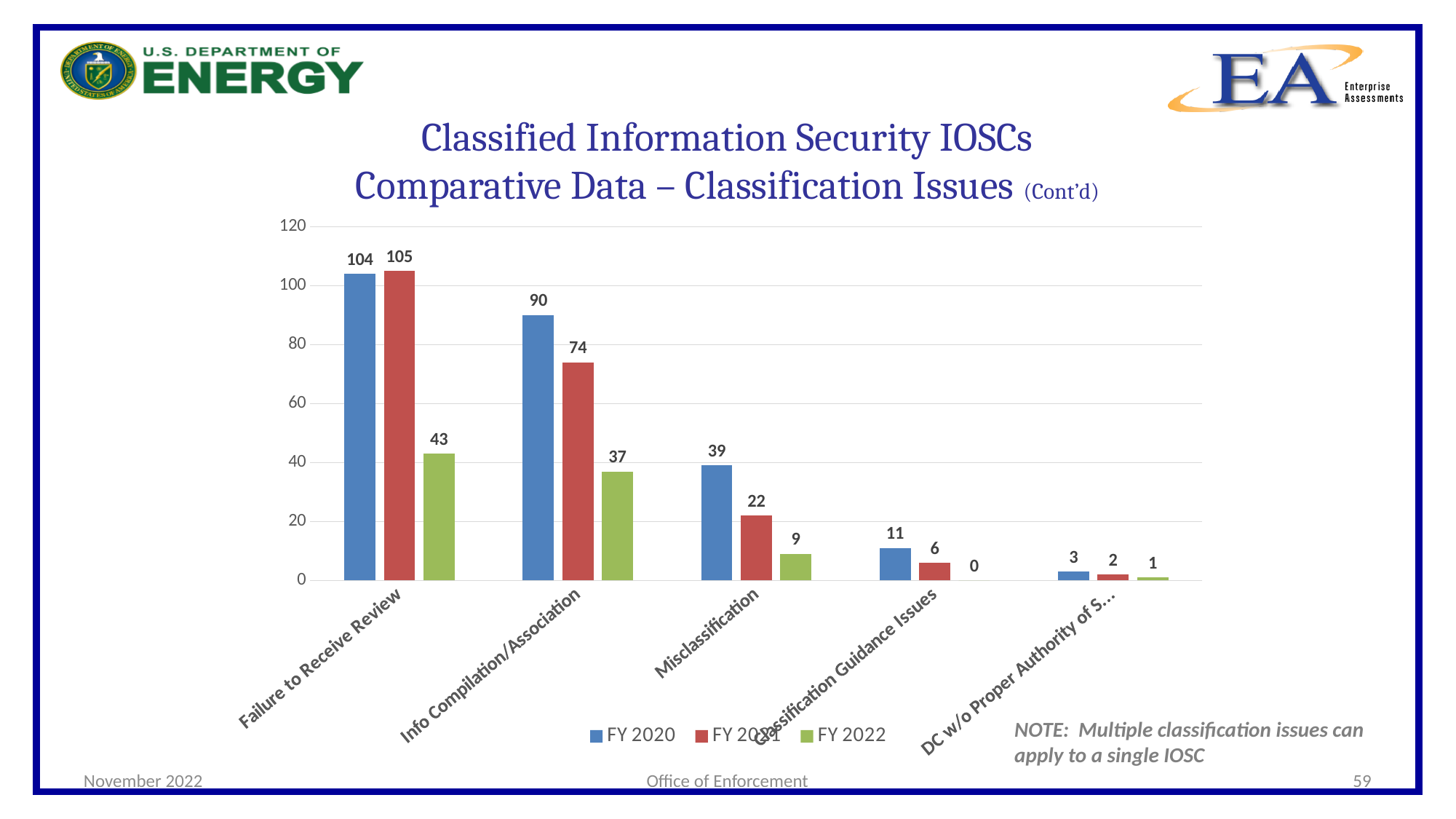
What is the FY 2022 value for Classification Guidance Issues? 0 What is the FY 2020 value for Misclassification? 39 Which category has the highest FY 2020 value? Failure to Receive Review What is the FY 2021 value for Info Compilation/Association? 74 Which category has the lowest FY 2022 value? Classification Guidance Issues How many series does the legend list? 3 What kind of chart is shown on the slide? Bar chart What is the difference between the FY 2020 and FY 2022 values for Info Compilation/Association? 53 What is the FY 2022 value for Failure to Receive Review? 43 Which is larger for Failure to Receive Review: the FY 2020 value or the FY 2021 value? FY 2021 How many categories are shown on the x axis? 5 Do the FY 2020 values rise or fall moving from left to right across the categories? Fall